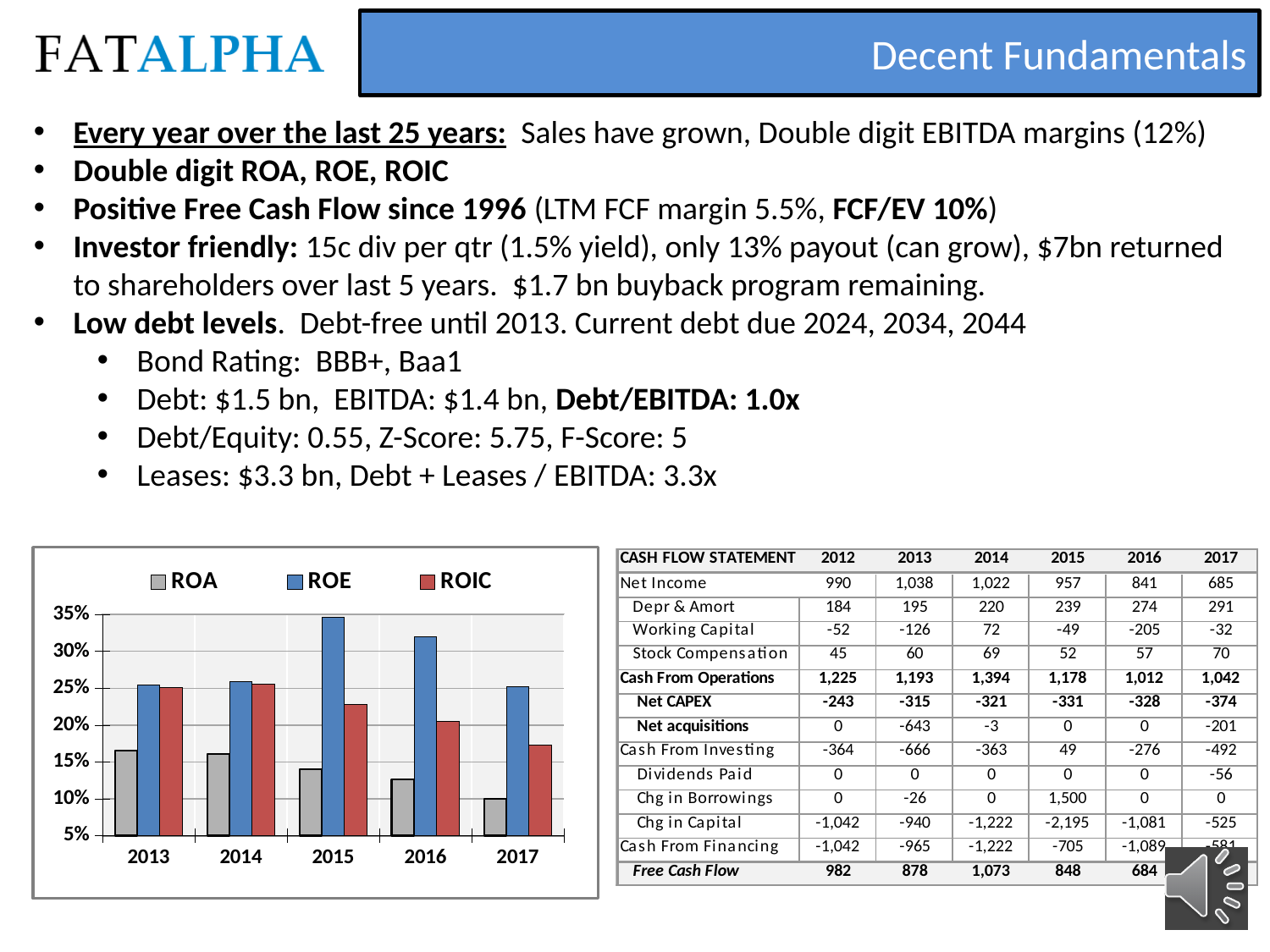
Does ROA rise or fall from 2013 to 2017? fall How many series does the chart's legend list? 3 Which is larger, ROIC in 2013 or ROIC in 2017? ROIC in 2013 Which colour represents ROE in the chart? blue In which year is ROE highest? 2015 In which year is ROIC lowest? 2017 Is the value for ROE in 2015 greater or less than 30%? greater In which year is ROA lowest? 2017 What kind of chart is shown on the slide? bar chart Is the value for ROA in 2017 greater or less than 15%? less How many years are shown on the x axis of the chart? 5 Which is larger in 2015, ROE or ROA? ROE